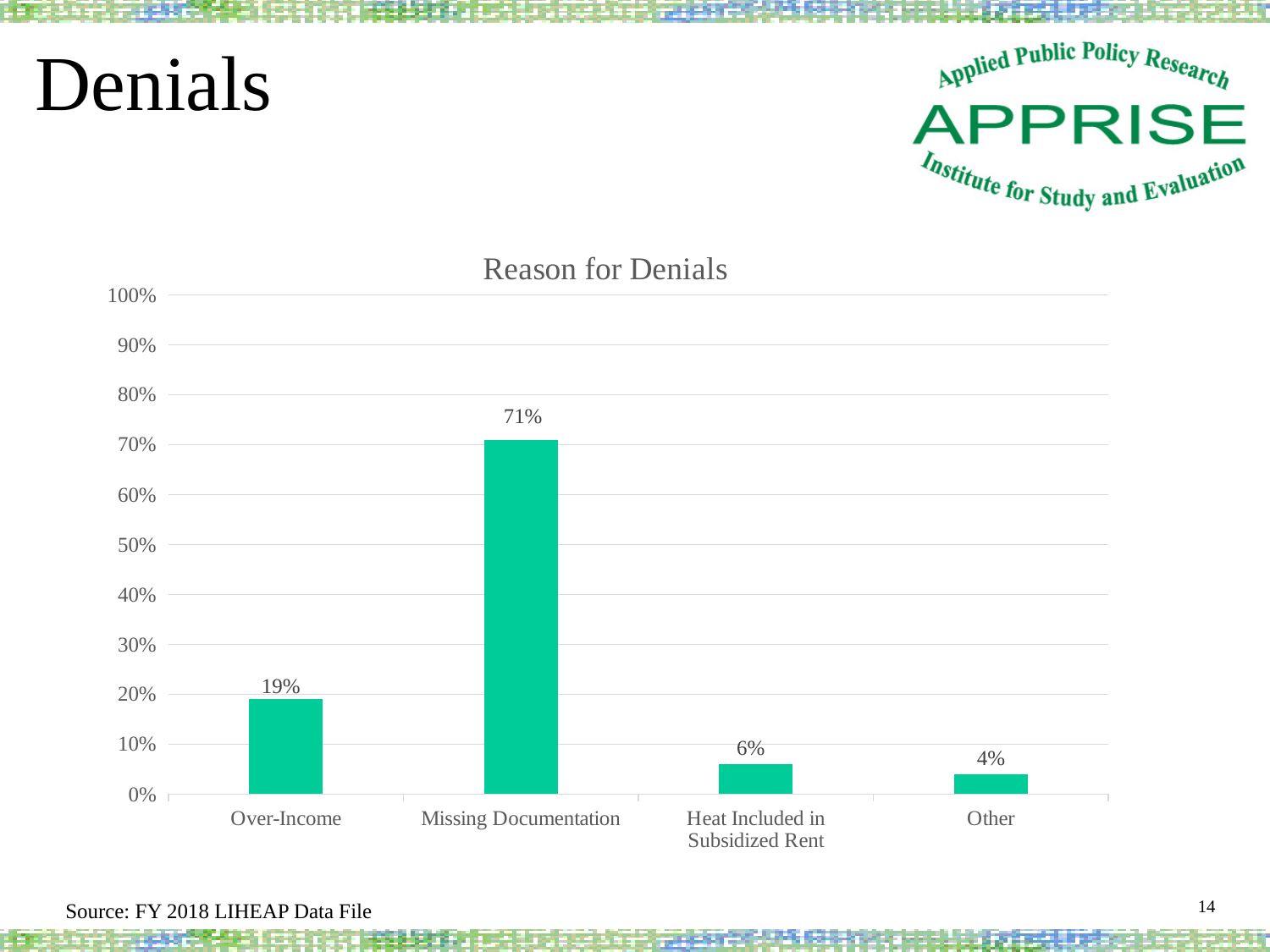
How many categories are shown on the x axis? 4 Which reason for denial has the lowest value? Other What is the value for Other? 4% What is the difference between the values for Missing Documentation and Over-Income? 52% What is the value for Missing Documentation? 71% What is the value for Over-Income? 19% What is the title of the chart? Reason for Denials What kind of chart is shown on the slide? bar chart What is the value for Heat Included in Subsidized Rent? 6% Which is larger, the value for Over-Income or the value for Heat Included in Subsidized Rent? Over-Income Is the value for Missing Documentation greater or less than 50%? greater Which reason for denial has the highest value? Missing Documentation